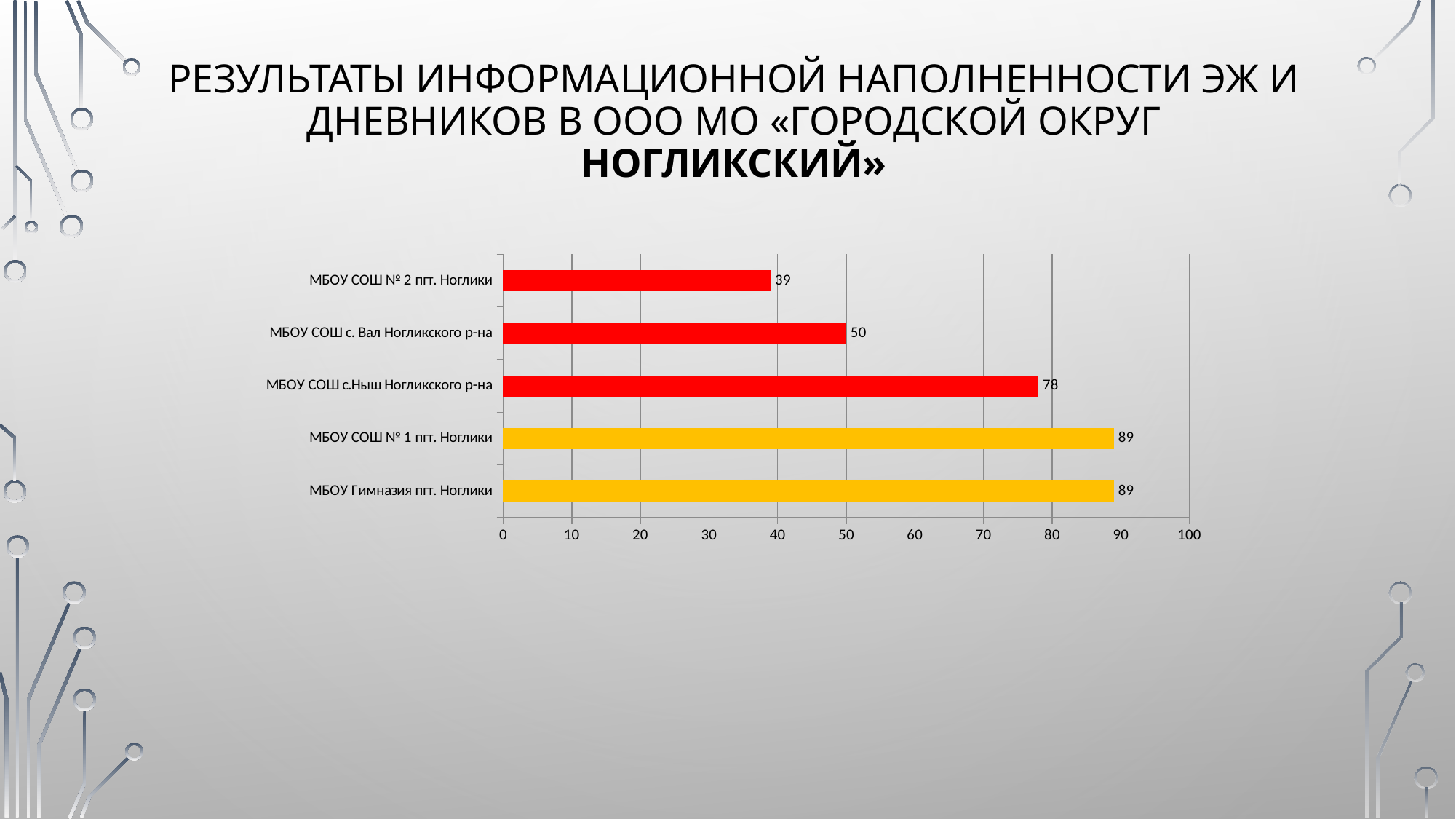
What is the difference between the values for МБОУ СОШ № 1 пгт. Ноглики and МБОУ СОШ № 2 пгт. Ноглики? 50 Which school has the lowest value? МБОУ СОШ № 2 пгт. Ноглики What is the difference between the values for МБОУ СОШ с.Ныш Ногликского р-на and МБОУ СОШ с. Вал Ногликского р-на? 28 What is the value for МБОУ СОШ с. Вал Ногликского р-на? 50 Which has a larger value, МБОУ СОШ с. Вал Ногликского р-на or МБОУ СОШ с.Ныш Ногликского р-на? МБОУ СОШ с.Ныш Ногликского р-на What kind of chart is shown on the slide? bar chart What is the value for МБОУ СОШ № 2 пгт. Ноглики? 39 Is the value for МБОУ СОШ № 2 пгт. Ноглики greater or less than 40? less What is the value for МБОУ Гимназия пгт. Ноглики? 89 What colour are the bars for МБОУ СОШ № 1 пгт. Ноглики and МБОУ Гимназия пгт. Ноглики? yellow What is the value for МБОУ СОШ с.Ныш Ногликского р-на? 78 How many schools are shown in the chart? 5